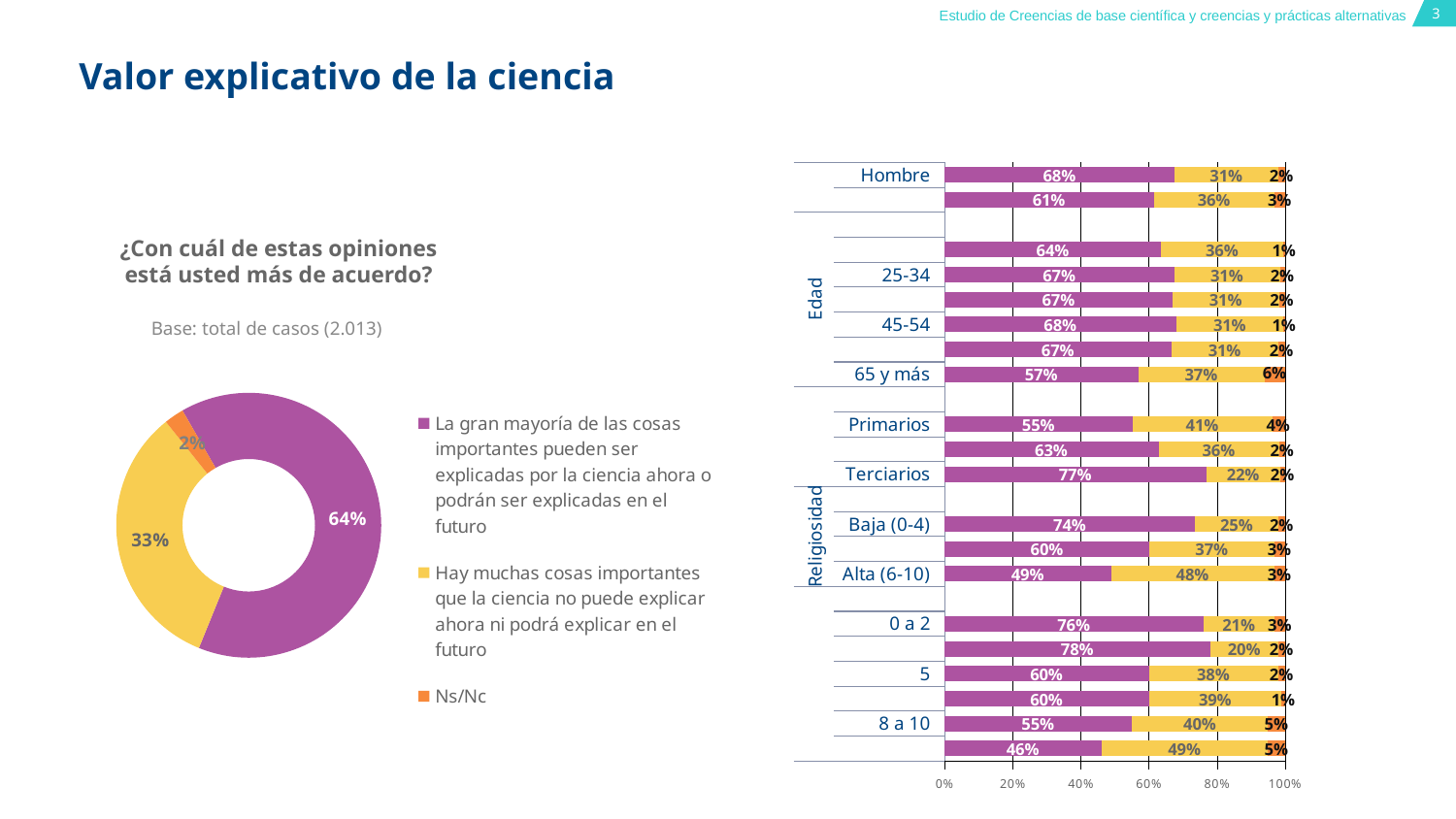
In the bar chart on the right, what is the difference between the purple segment for 'Terciarios' and the purple segment for 'Primarios'? 22 percentage points In the bar chart on the right, what is the value of the purple segment for 'Hombre'? 68% How many entries does the legend of the chart on the left list? 3 What kind of chart is the chart on the right of the slide? Bar chart What is the base (number of cases) stated on the slide? 2.013 In the bar chart on the right, what is the value of the orange segment for '65 y más'? 6% In the donut chart on the left, what percentage is shown for the opinion 'La gran mayoría de las cosas importantes pueden ser explicadas por la ciencia ahora o podrán ser explicadas en el futuro'? 64% In the donut chart on the left, what percentage corresponds to 'Ns/Nc'? 2% In the bar chart on the right, which has a larger purple segment: 'Baja (0-4)' or 'Alta (6-10)'? Baja (0-4) What kind of chart is the chart on the left of the slide? Doughnut chart In the bar chart on the right, what is the value of the yellow segment for 'Alta (6-10)'? 48% In the donut chart on the left, what percentage is shown for 'Hay muchas cosas importantes que la ciencia no puede explicar ahora ni podrá explicar en el futuro'? 33%